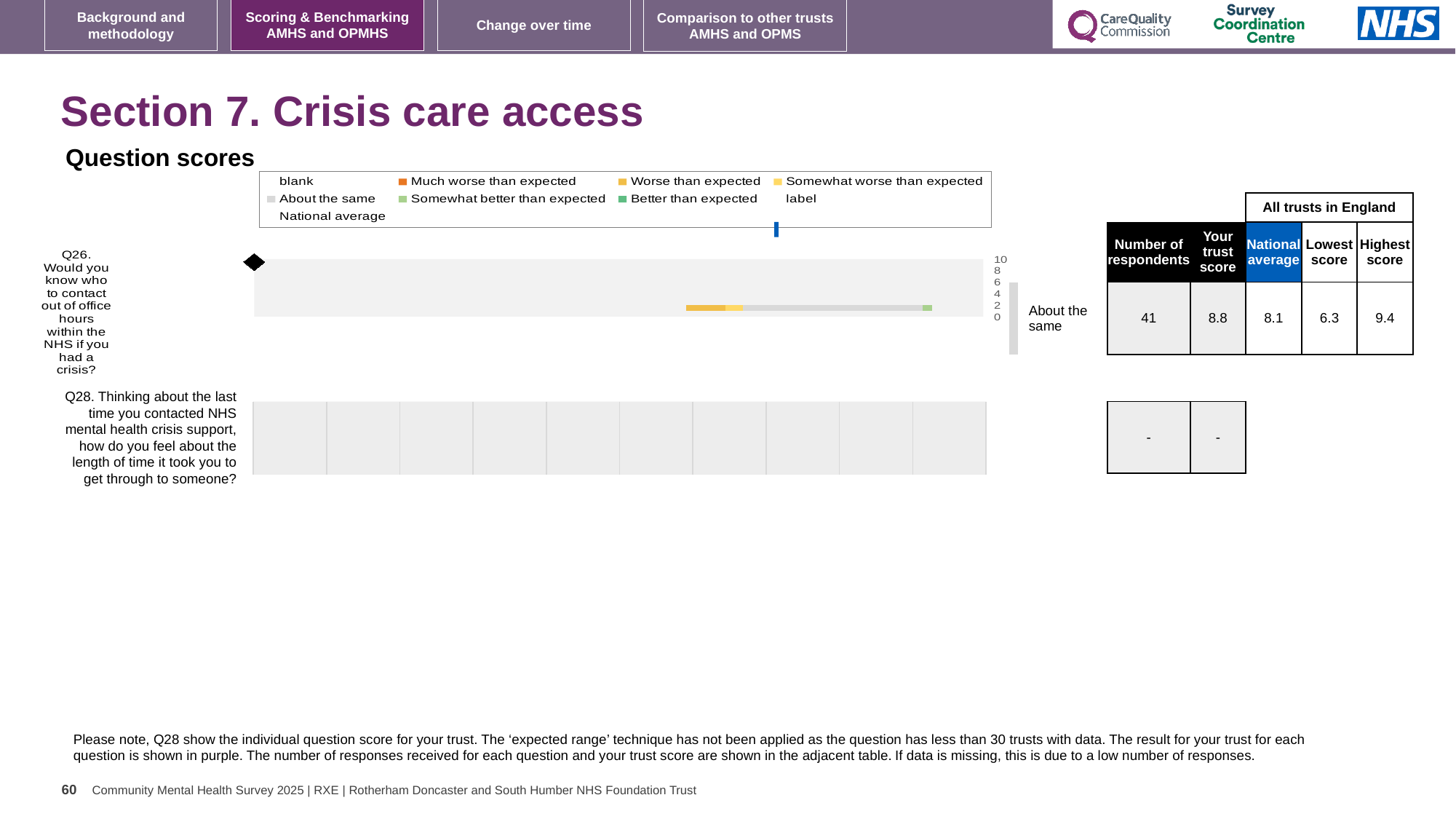
What is the lowest score among all trusts in England for Q26? 6.3 How many respondents answered Q26? 41 How many questions are plotted in the Question scores chart? 2 What is the highest score among all trusts in England for Q26? 9.4 What kind of chart is used to show the question scores for Section 7? bar chart What is the national average for Q26? 8.1 Which benchmark category is shown for Q26 in the chart? About the same By how much does the trust score for Q26 exceed the national average? 0.7 What is the trust score for Q26 shown next to the chart? 8.8 What is the difference between the highest and lowest scores for Q26 across all trusts in England? 3.1 What colour represents 'Much worse than expected' in the chart legend? orange For Q26, which is larger: the trust score or the national average? the trust score